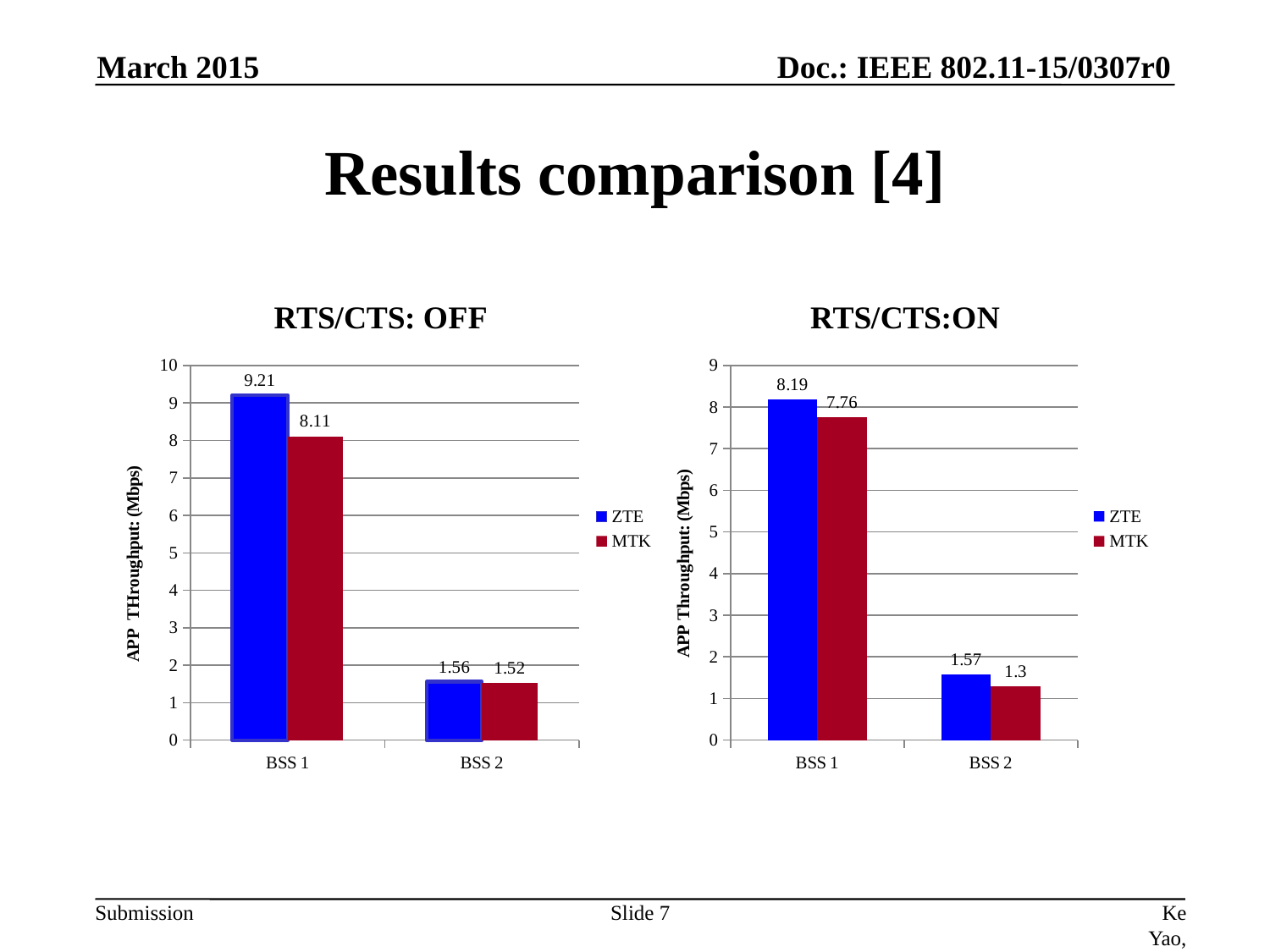
In the RTS/CTS:ON chart, which category has the lowest MTK value? BSS 2 How many categories are shown on the x axis of the RTS/CTS:ON chart? 2 What type of chart is the RTS/CTS: OFF chart? Bar chart In the RTS/CTS: OFF chart, which category has the highest ZTE value? BSS 1 In the RTS/CTS:ON chart, what is the MTK value for BSS 1? 7.76 In the RTS/CTS: OFF chart, what is the ZTE value for BSS 1? 9.21 How many series does the legend of the RTS/CTS: OFF chart list? 2 In the RTS/CTS:ON chart, what is the ZTE value for BSS 2? 1.57 In the RTS/CTS:ON chart, which series has the larger value for BSS 1, ZTE or MTK? ZTE In the RTS/CTS: OFF chart, what is the MTK value for BSS 2? 1.52 In the RTS/CTS:ON chart, what is the difference between the ZTE and MTK values for BSS 2? 0.27 In the RTS/CTS: OFF chart, what is the difference between the ZTE and MTK values for BSS 1? 1.1